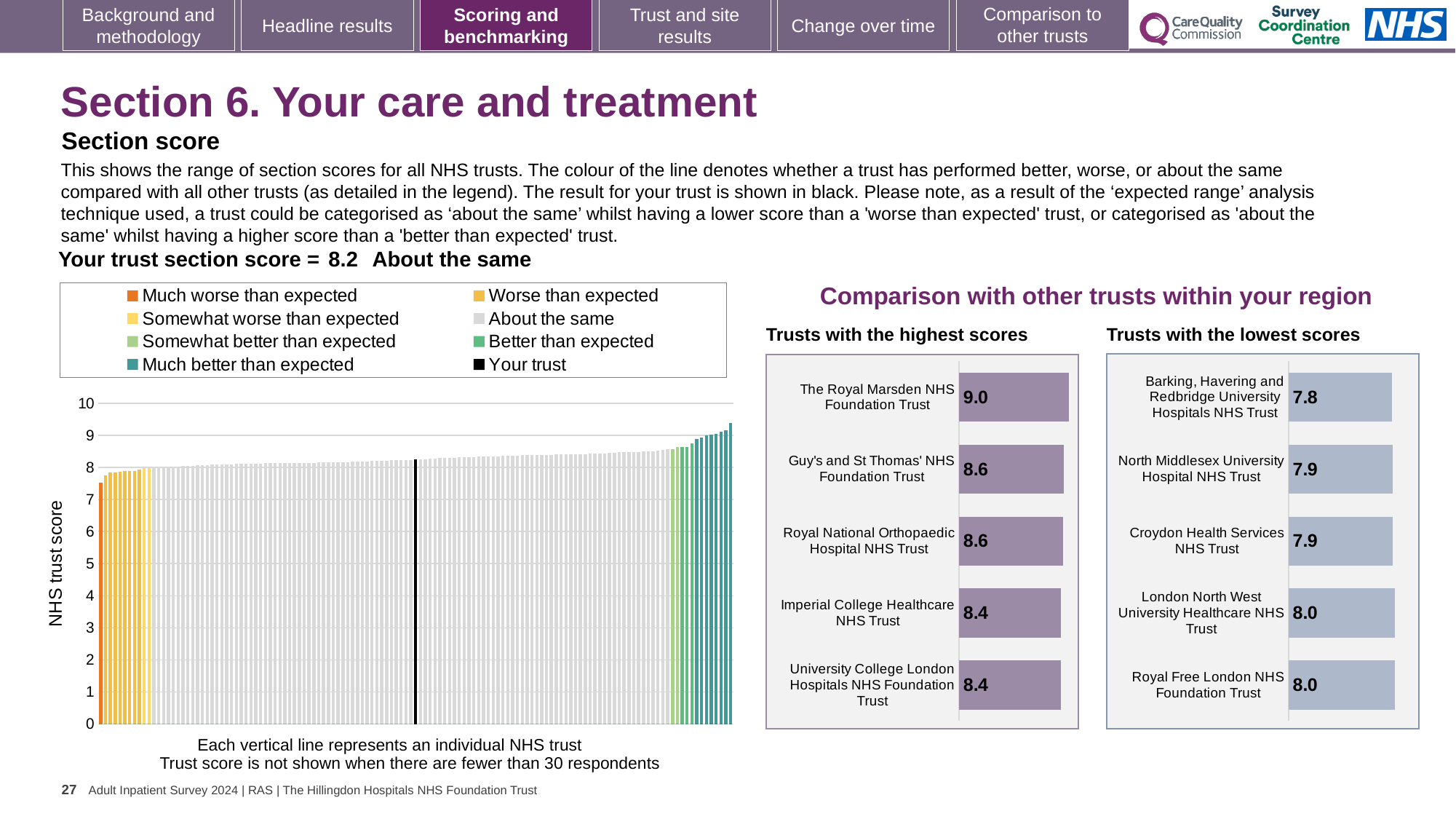
In the 'Trusts with the highest scores' chart, which has the higher score: Guy's and St Thomas' NHS Foundation Trust or Imperial College Healthcare NHS Trust? Guy's and St Thomas' NHS Foundation Trust In the legend of the large 'NHS trust score' chart, what colour represents 'Your trust'? Black In the large 'NHS trust score' chart, is the value for the lowest-scoring trust (the leftmost bar) greater or less than 8? less In the 'Trusts with the highest scores' chart, which trust has the highest score? The Royal Marsden NHS Foundation Trust In the 'Trusts with the highest scores' chart, what is the score for The Royal Marsden NHS Foundation Trust? 9.0 In the 'Trusts with the lowest scores' chart, what is the score for Barking, Havering and Redbridge University Hospitals NHS Trust? 7.8 In the 'Trusts with the lowest scores' chart, which trust has the lowest score? Barking, Havering and Redbridge University Hospitals NHS Trust What kind of chart is the large 'NHS trust score' chart on the left of the slide? Bar chart How many trusts are shown in the 'Trusts with the lowest scores' chart? 5 In the 'Trusts with the lowest scores' chart, what is the difference between the scores of Royal Free London NHS Foundation Trust and Barking, Havering and Redbridge University Hospitals NHS Trust? 0.2 How many entries does the legend of the large 'NHS trust score' chart list? 8 In the 'Trusts with the highest scores' chart, what is the difference between the scores of The Royal Marsden NHS Foundation Trust and Imperial College Healthcare NHS Trust? 0.6